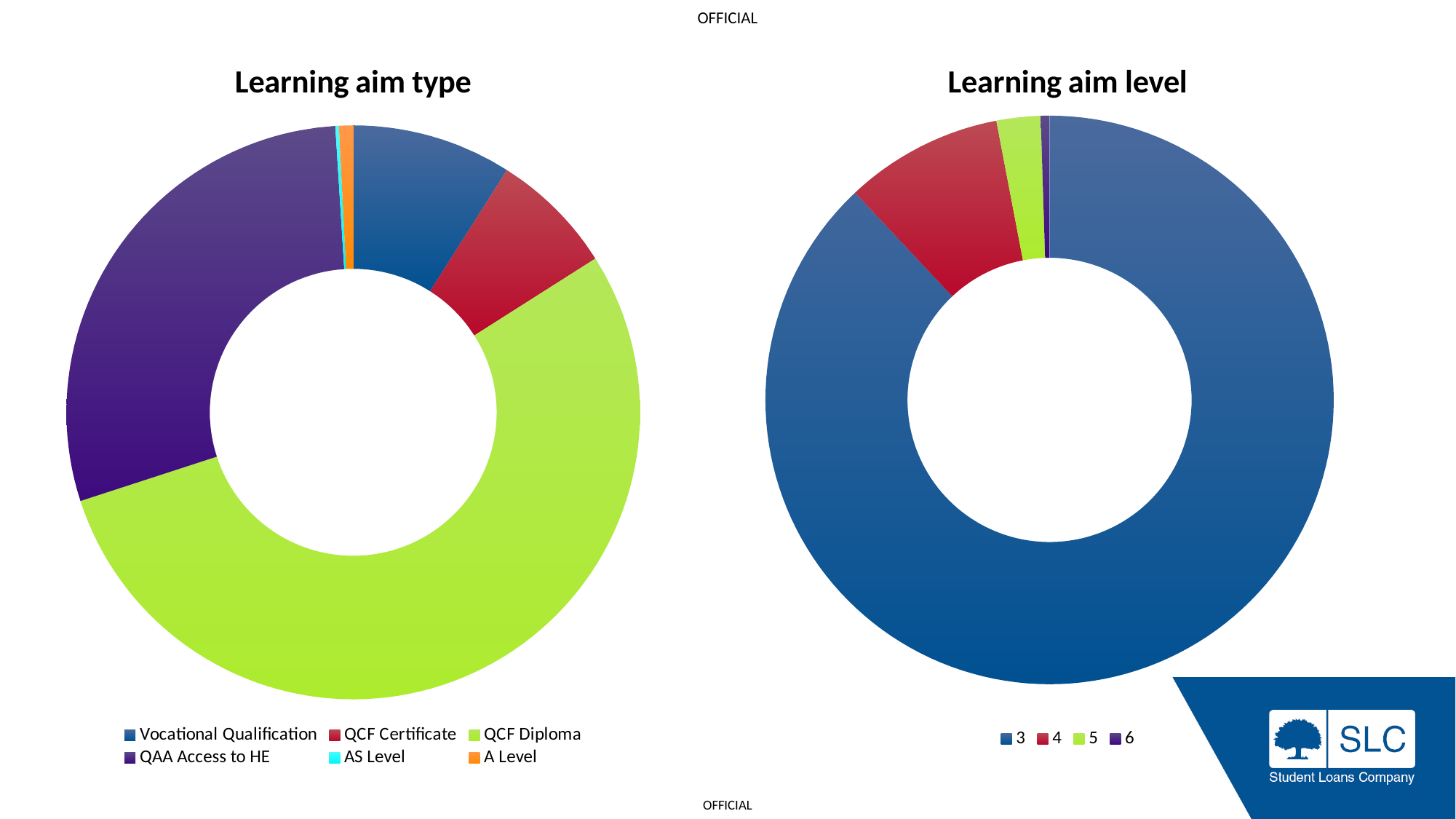
What kind of chart is the 'Learning aim type' chart? doughnut chart In the 'Learning aim type' chart, which category has the smallest slice? AS Level In the 'Learning aim level' chart, which level has the largest slice? 3 In the 'Learning aim type' chart, which category has the largest slice? QCF Diploma In the 'Learning aim level' chart, how many categories does the legend list? 4 What is the title of the chart on the right side of the slide? Learning aim level What kind of chart is the 'Learning aim level' chart? doughnut chart In the 'Learning aim type' chart, how many categories does the legend list? 6 In the 'Learning aim level' chart, which slice is larger: level 4 or level 5? 4 In the 'Learning aim type' chart, which slice is larger: QAA Access to HE or Vocational Qualification? QAA Access to HE In the 'Learning aim level' chart, which level has the smallest slice? 6 In the 'Learning aim type' chart, what colour is the QCF Diploma slice? green